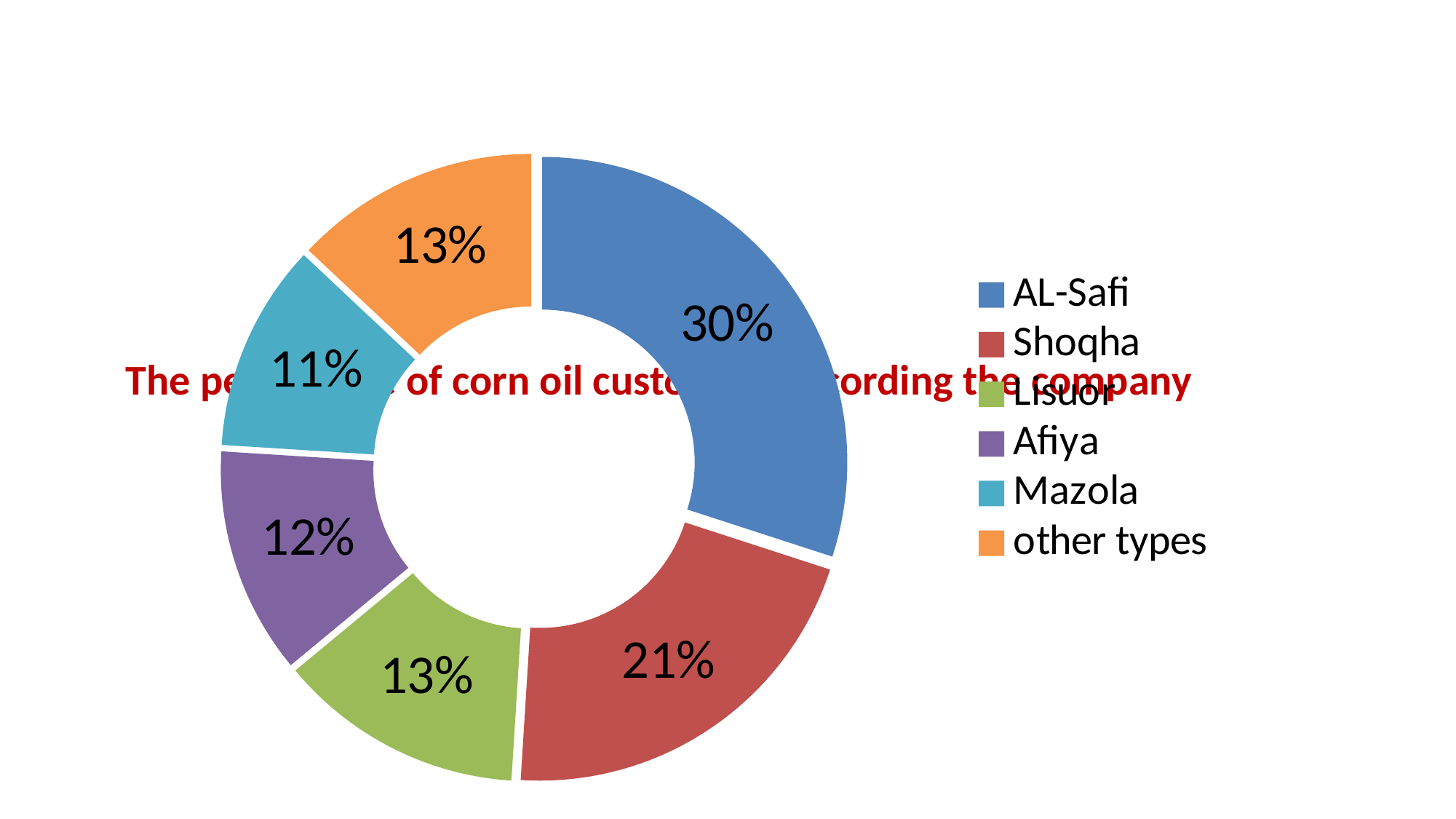
What percentage is shown for Mazola? 11% What percentage is shown for Shoqha? 21% Which company has the smallest share of corn oil customers? Mazola Which company has the largest share of corn oil customers? AL-Safi What percentage is shown for other types? 13% How many categories are shown in the chart? 6 What kind of chart is shown on the slide? Doughnut (pie) chart What colour represents Shoqha in the chart? Red What percentage is shown for Afiya? 12% What is the difference in percentage points between AL-Safi and Shoqha? 9 What percentage of corn oil customers does AL-Safi account for? 30% Which has a larger share, Afiya or Mazola? Afiya